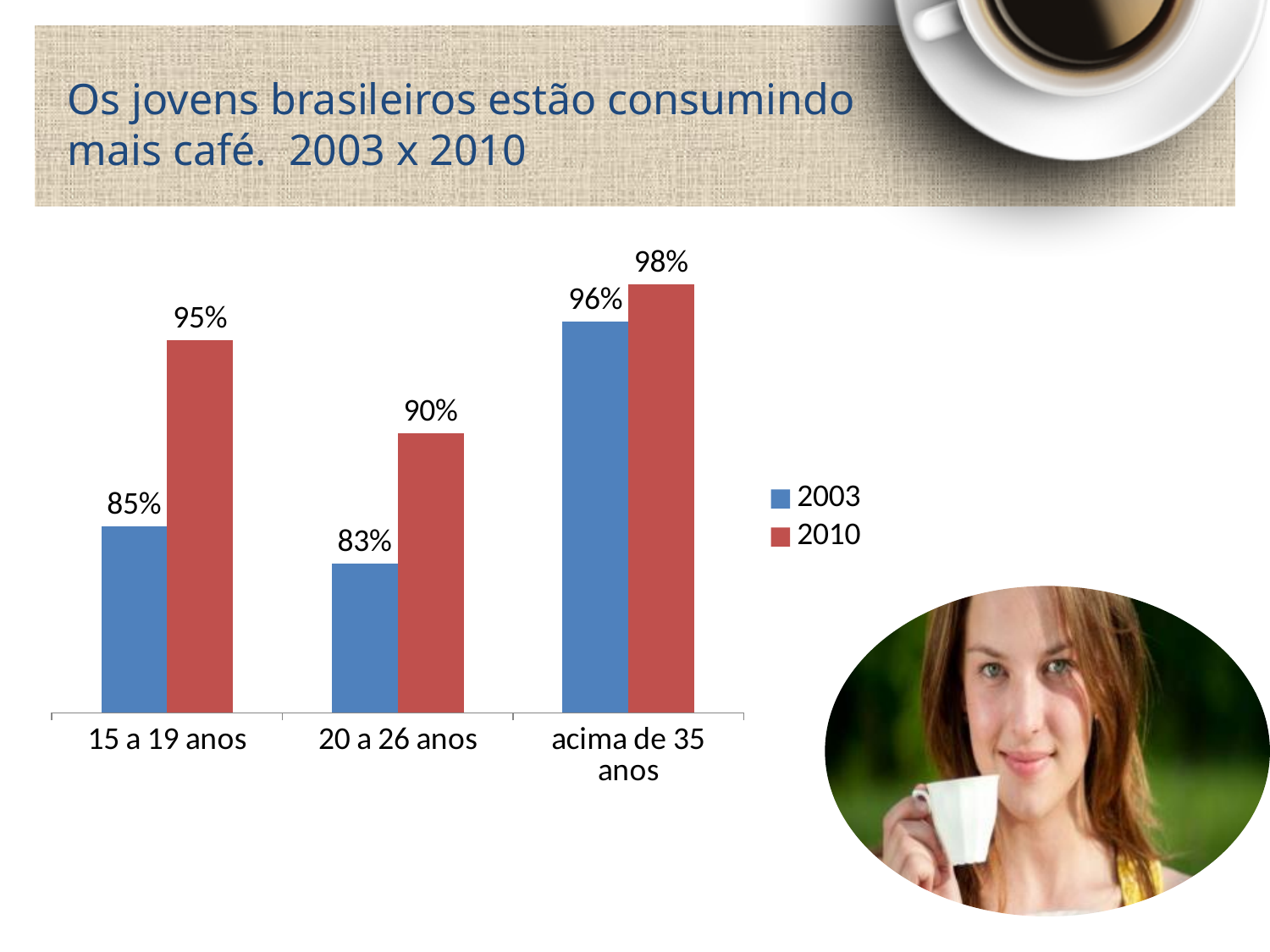
What is the difference between the 2010 and 2003 values for '15 a 19 anos'? 10% What is the value for 2003 in the '15 a 19 anos' category? 85% What kind of chart is shown on the slide? bar chart Which category has the highest value for 2003? acima de 35 anos Which is larger: the 2003 value for '15 a 19 anos' or the 2003 value for '20 a 26 anos'? 15 a 19 anos What is the value for 2010 in the '20 a 26 anos' category? 90% Which category has the lowest value for 2010? 20 a 26 anos What is the difference between the 2010 and 2003 values for '20 a 26 anos'? 7% How many age categories are shown on the x axis? 3 Which category has the lowest value for 2003? 20 a 26 anos How many series does the legend list? 2 What is the value for 2010 in the 'acima de 35 anos' category? 98%